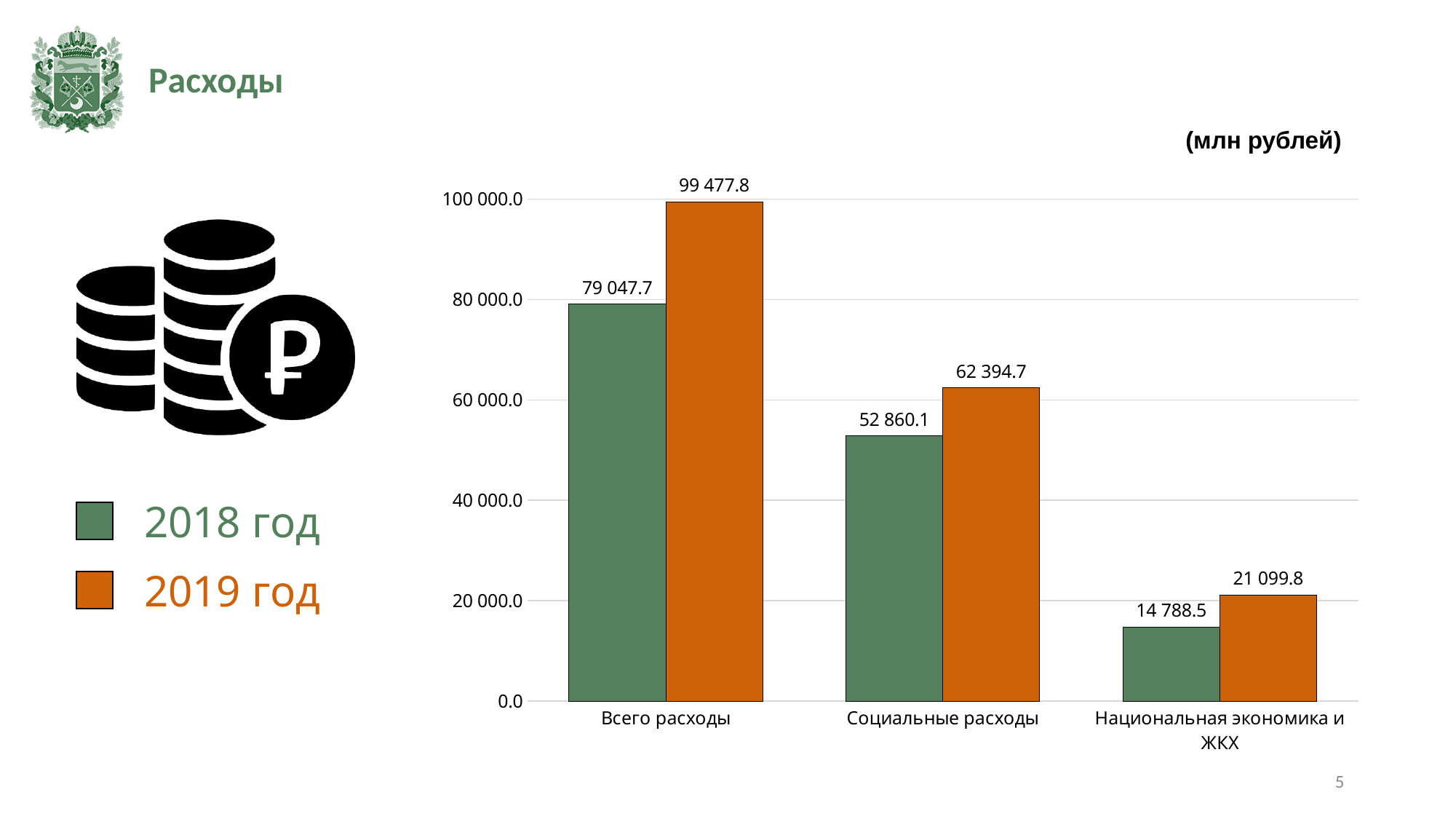
Which category has the lowest value for 2018 год? Национальная экономика и ЖКХ What is the value for 2019 год in the Всего расходы category? 99 477.8 What is the difference between the 2019 год and 2018 год values for Социальные расходы? 9 534.6 What is the value for 2018 год in the Всего расходы category? 79 047.7 How many categories are shown on the x axis of the chart? 3 What is the value for 2019 год in the Национальная экономика и ЖКХ category? 21 099.8 What is the difference between the 2019 год and 2018 год values for Всего расходы? 20 430.1 Which category has the highest value for 2019 год? Всего расходы What type of chart is shown on the slide? Bar chart What is the value for 2018 год in the Социальные расходы category? 52 860.1 Which is larger for Национальная экономика и ЖКХ: the 2018 год value or the 2019 год value? 2019 год How many series does the legend list? 2